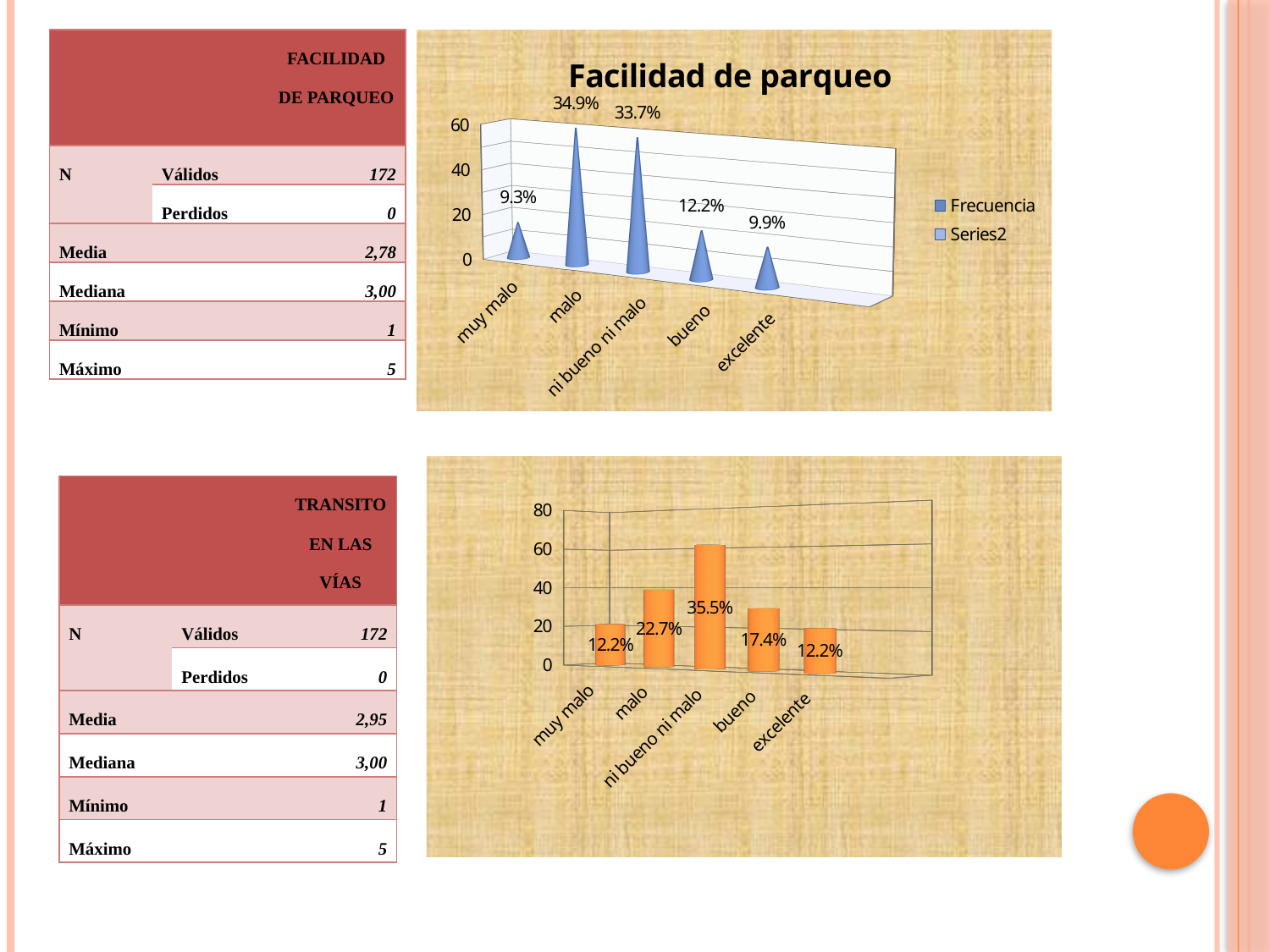
In the 'Facilidad de parqueo' chart, what data label is shown for 'malo'? 34.9% What kind of chart is the bottom chart? bar chart In the bottom chart, what data label is shown for 'ni bueno ni malo'? 35.5% In the 'Facilidad de parqueo' chart, what data label is shown for 'excelente'? 9.9% In the 'Facilidad de parqueo' chart, is the value for 'malo' greater or less than 40? greater In the 'Facilidad de parqueo' chart, which category has the highest value? malo In the 'Facilidad de parqueo' chart, how many entries does the legend list? 2 In the bottom chart, is the value for 'ni bueno ni malo' greater or less than 40? greater In the bottom chart, which category has the highest value? ni bueno ni malo In the bottom chart, what data label is shown for 'bueno'? 17.4% In the bottom chart, how many categories are shown on the x axis? 5 In the 'Facilidad de parqueo' chart, which category has the lowest value? muy malo